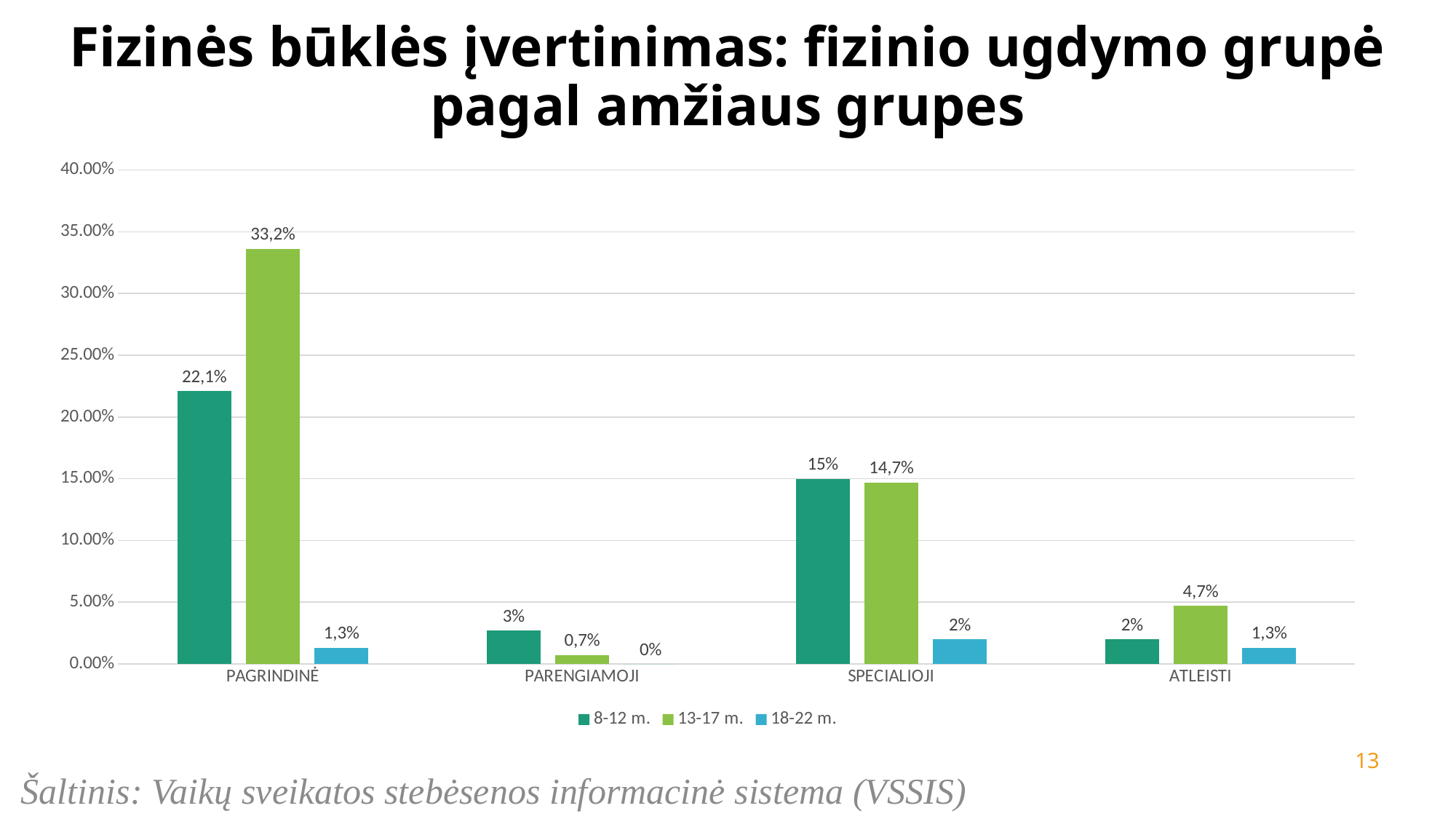
What is the value for 13-17 m. in the ATLEISTI category? 4,7% What is the value for 8-12 m. in the SPECIALIOJI category? 15% What kind of chart is shown on the slide? Bar chart Which category has the lowest value for the 13-17 m. series? PARENGIAMOJI What is the difference between the 13-17 m. and 8-12 m. values in the PAGRINDINĖ category? 11,1% Which category has the highest value for the 8-12 m. series? PAGRINDINĖ In the SPECIALIOJI category, which is larger: the 8-12 m. value or the 13-17 m. value? 8-12 m. What is the value for 13-17 m. in the PAGRINDINĖ category? 33,2% How many series does the legend list? 3 How many categories are shown on the x axis? 4 Is the value for 13-17 m. in PAGRINDINĖ greater or less than 30.00%? greater What is the value for 18-22 m. in the PARENGIAMOJI category? 0%